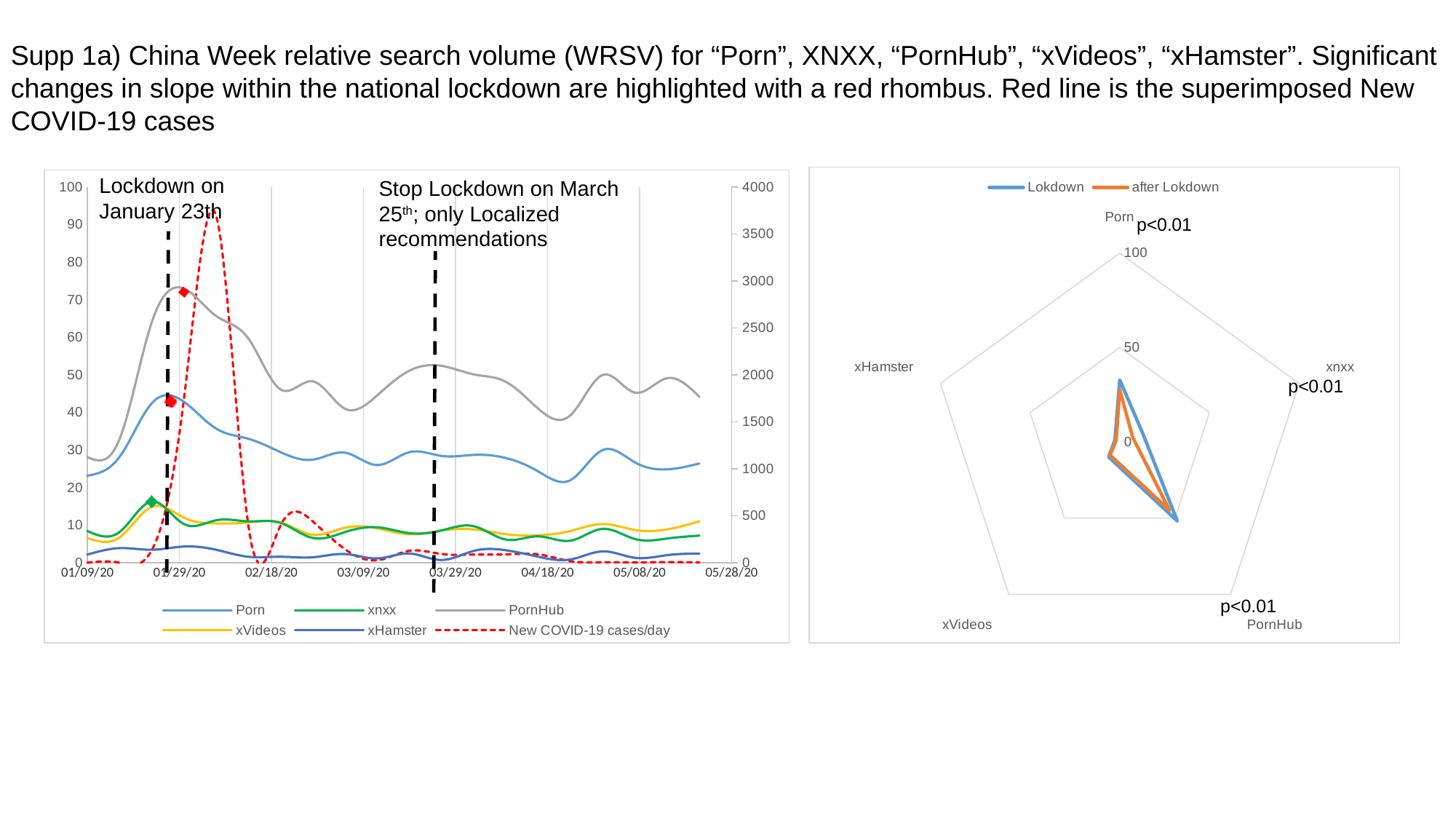
In the left chart, which search-volume series has the lowest values across the period? xHamster How many categories (axes) does the radar chart on the right have? 5 In the left chart, is the peak value of the PornHub line greater or less than 60? greater In the left chart, which search-volume series has the highest values across the period? PornHub In the left chart, does the PornHub line rise or fall between 01/29/20 and 02/18/20? fall In the left chart, is the peak of the New COVID-19 cases/day line greater or less than 3500 on the right axis? greater In the right chart, which series has the larger value for Porn, Lokdown or after Lokdown? Lokdown In the right chart, is the Lokdown value for Porn greater or less than 50? less How many series does the legend of the right chart list? 2 How many series does the legend of the left chart list? 6 What kind of chart is the chart on the left of the slide? line chart What kind of chart is the chart on the right of the slide? radar chart